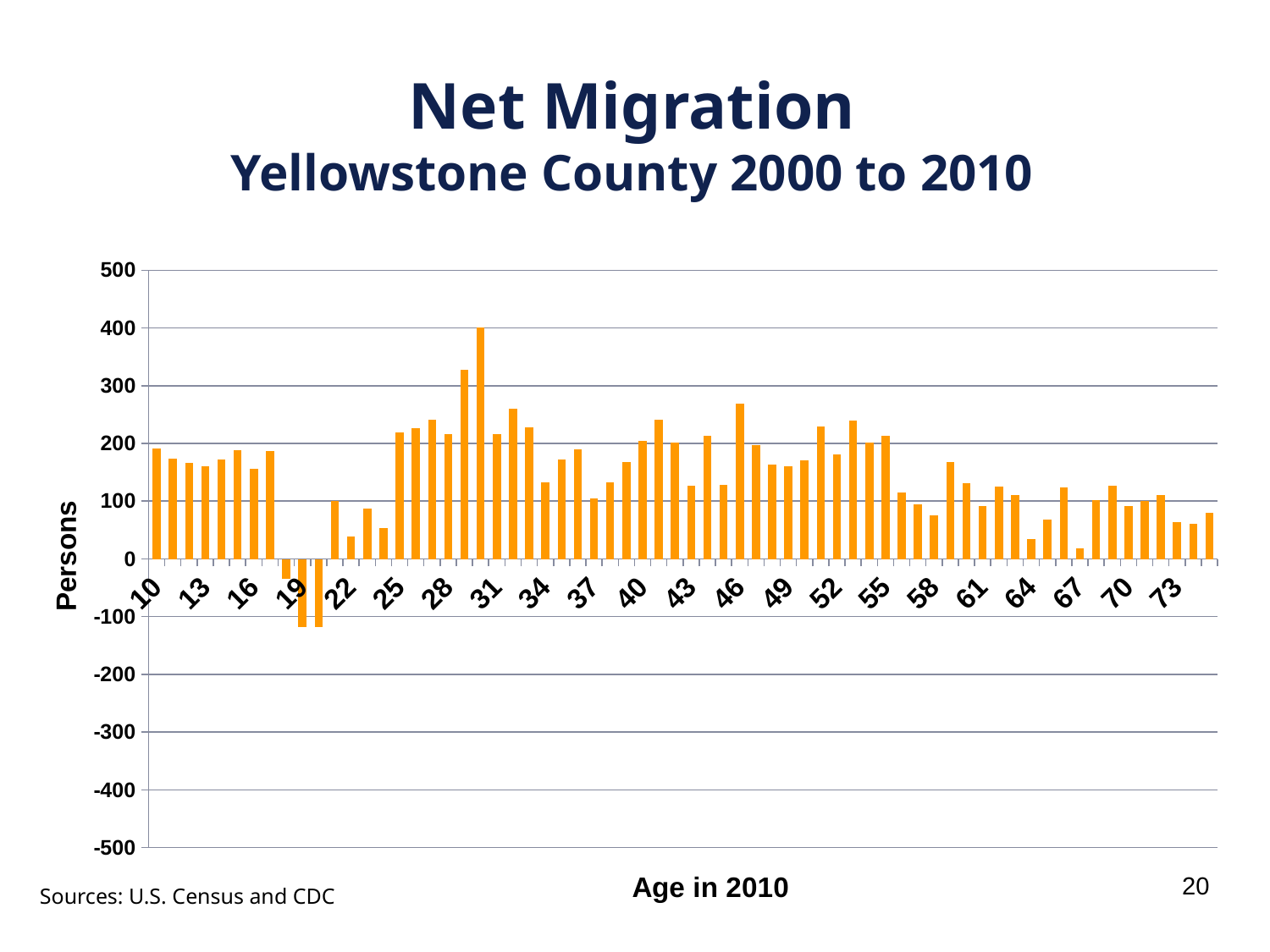
Is the value for age 30 greater or less than 300? greater Is the value for age 19 greater or less than -100? less Is the value for age 10 greater or less than 100? greater Which has the larger value, age 25 or age 22? 25 What type of chart is shown on the slide? bar chart What is the label on the horizontal axis? Age in 2010 Which has the larger value, age 46 or age 64? 46 How many bars fall below zero on the chart? 3 What is the label on the vertical axis? Persons Which age has the highest net migration value? 30